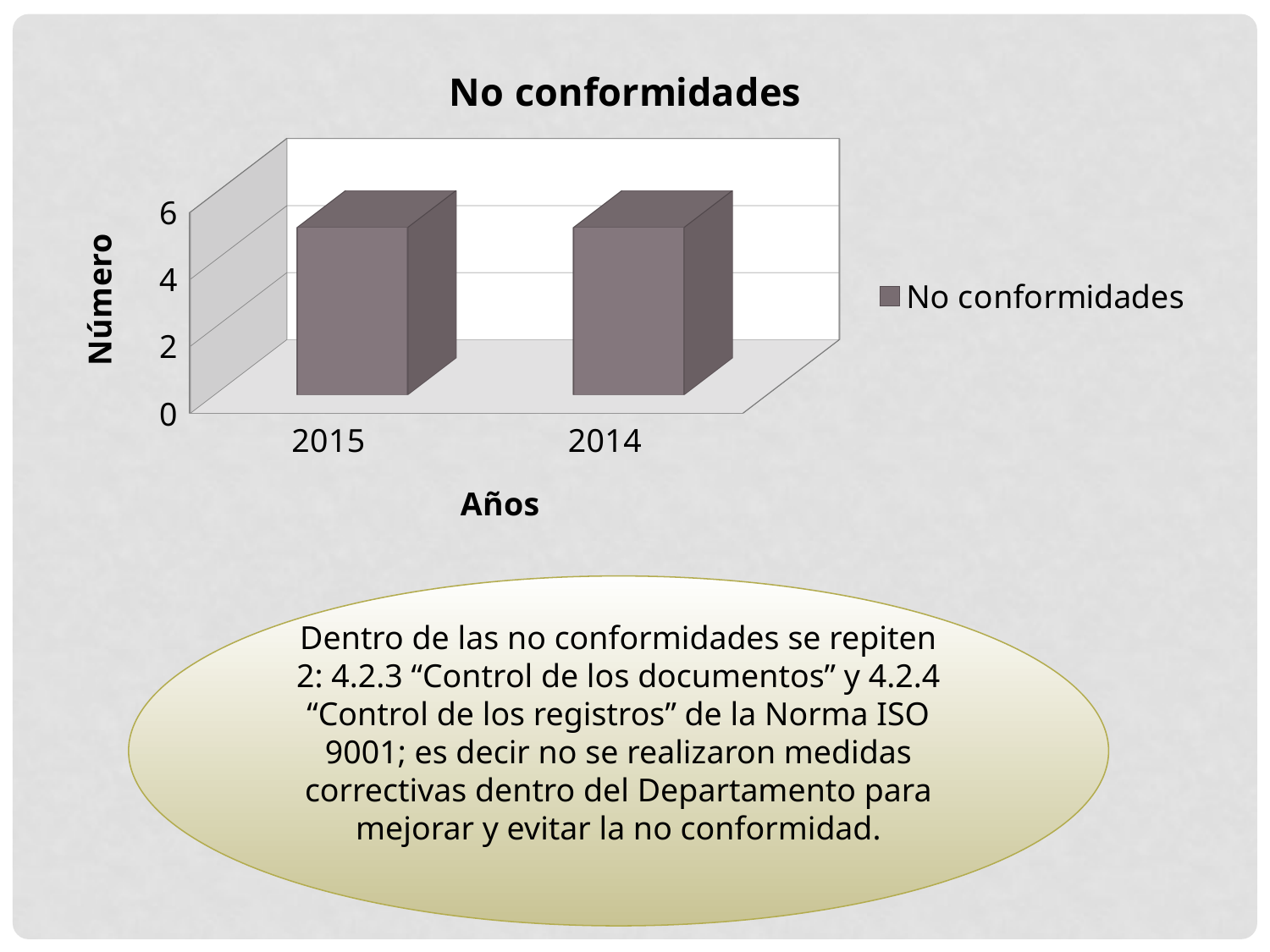
What is the title of the chart? No conformidades Is the value for 2014 greater or less than 6? less Is the value for 2014 greater or less than 4? greater How many series does the chart legend list? 1 How many categories are shown on the x axis of the chart? 2 Is the value for 2015 greater or less than 6? less What is the title of the vertical axis of the chart? Número What kind of chart is shown on the slide? bar chart